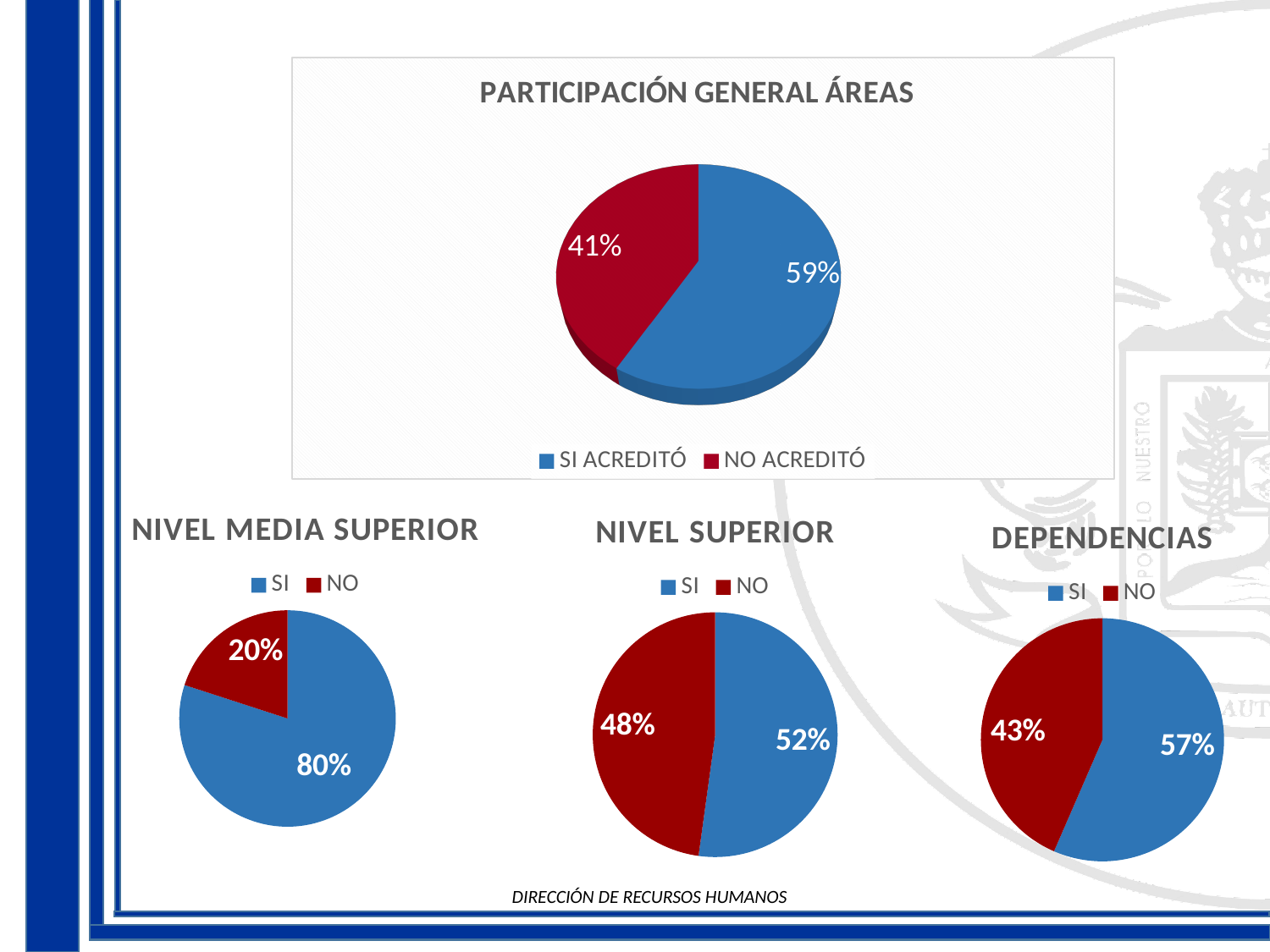
In the NIVEL MEDIA SUPERIOR chart, what is the value for NO? 20% In the NIVEL MEDIA SUPERIOR chart, what is the value for SI? 80% In the PARTICIPACIÓN GENERAL ÁREAS chart, what share is NO ACREDITÓ? 41% How many slices does the NIVEL SUPERIOR chart have? 2 In the DEPENDENCIAS chart, what is the value for SI? 57% In the NIVEL MEDIA SUPERIOR chart, what is the difference between SI and NO? 60% In the DEPENDENCIAS chart, what is the difference between SI and NO? 14% In the NIVEL SUPERIOR chart, which is larger, SI or NO? SI What kind of chart is the PARTICIPACIÓN GENERAL ÁREAS chart? Pie chart In the NIVEL SUPERIOR chart, what is the value for NO? 48% What are the legend entries of the PARTICIPACIÓN GENERAL ÁREAS chart? SI ACREDITÓ, NO ACREDITÓ In the PARTICIPACIÓN GENERAL ÁREAS chart, what share is SI ACREDITÓ? 59%